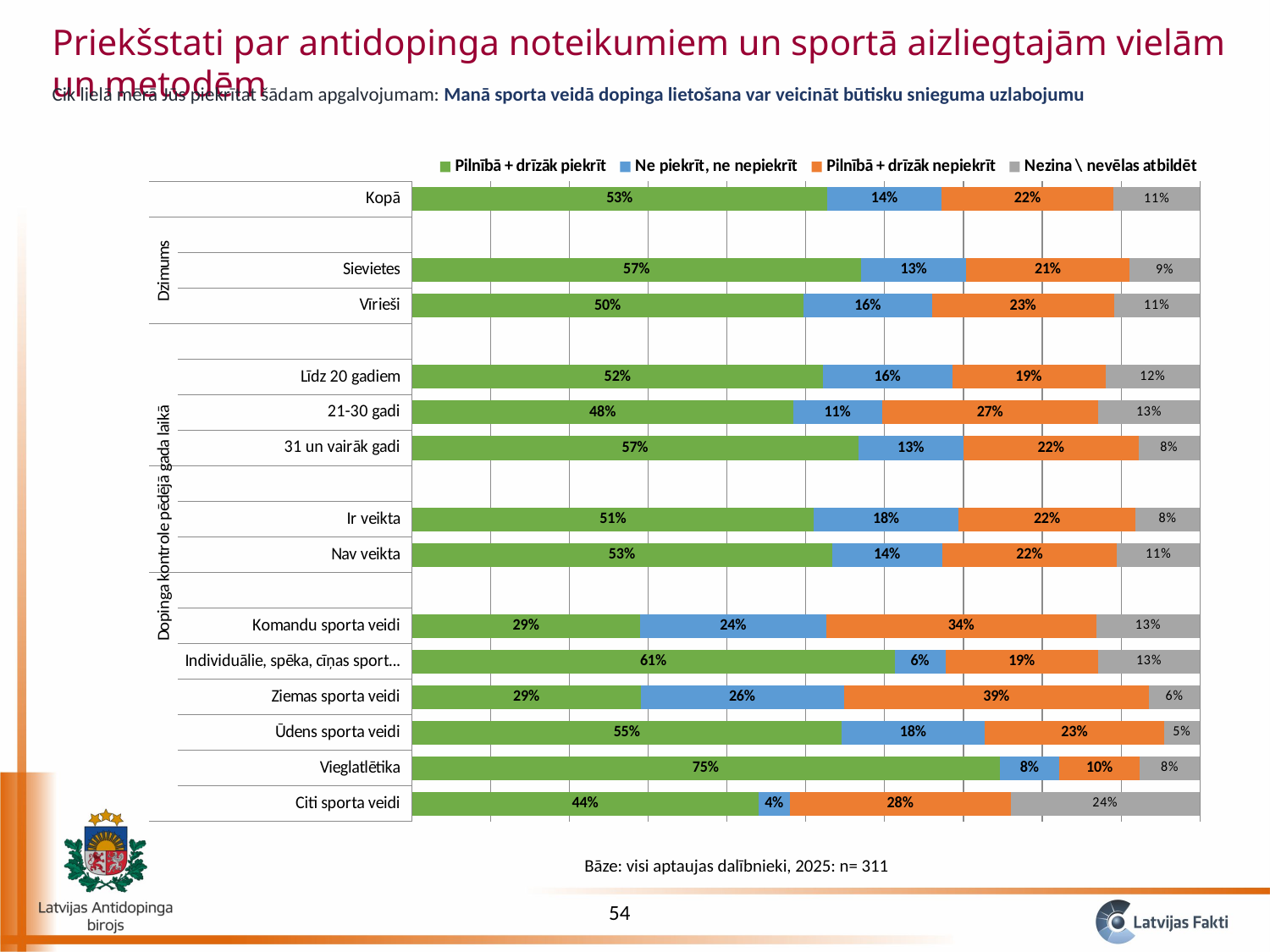
Which category has the highest value for "Pilnībā + drīzāk piekrīt"? Vieglatlētika How many series does the legend list? 4 What is the value of "Pilnībā + drīzāk piekrīt" for Kopā? 53% Which has a larger "Pilnībā + drīzāk nepiekrīt" value, 21-30 gadi or Līdz 20 gadiem? 21-30 gadi What is the value of "Pilnībā + drīzāk nepiekrīt" for Ziemas sporta veidi? 39% What kind of chart is shown on the slide? Stacked bar chart What is the value of "Nezina \ nevēlas atbildēt" for Citi sporta veidi? 24% What is the value of "Ne piekrīt, ne nepiekrīt" for Komandu sporta veidi? 24% What is the total of the stacked bar for Kopā? 100% Which category has the highest value for "Pilnībā + drīzāk nepiekrīt"? Ziemas sporta veidi What is the difference in "Pilnībā + drīzāk piekrīt" between Sievietes and Vīrieši? 7 percentage points Which category has the lowest value for "Nezina \ nevēlas atbildēt"? Ūdens sporta veidi